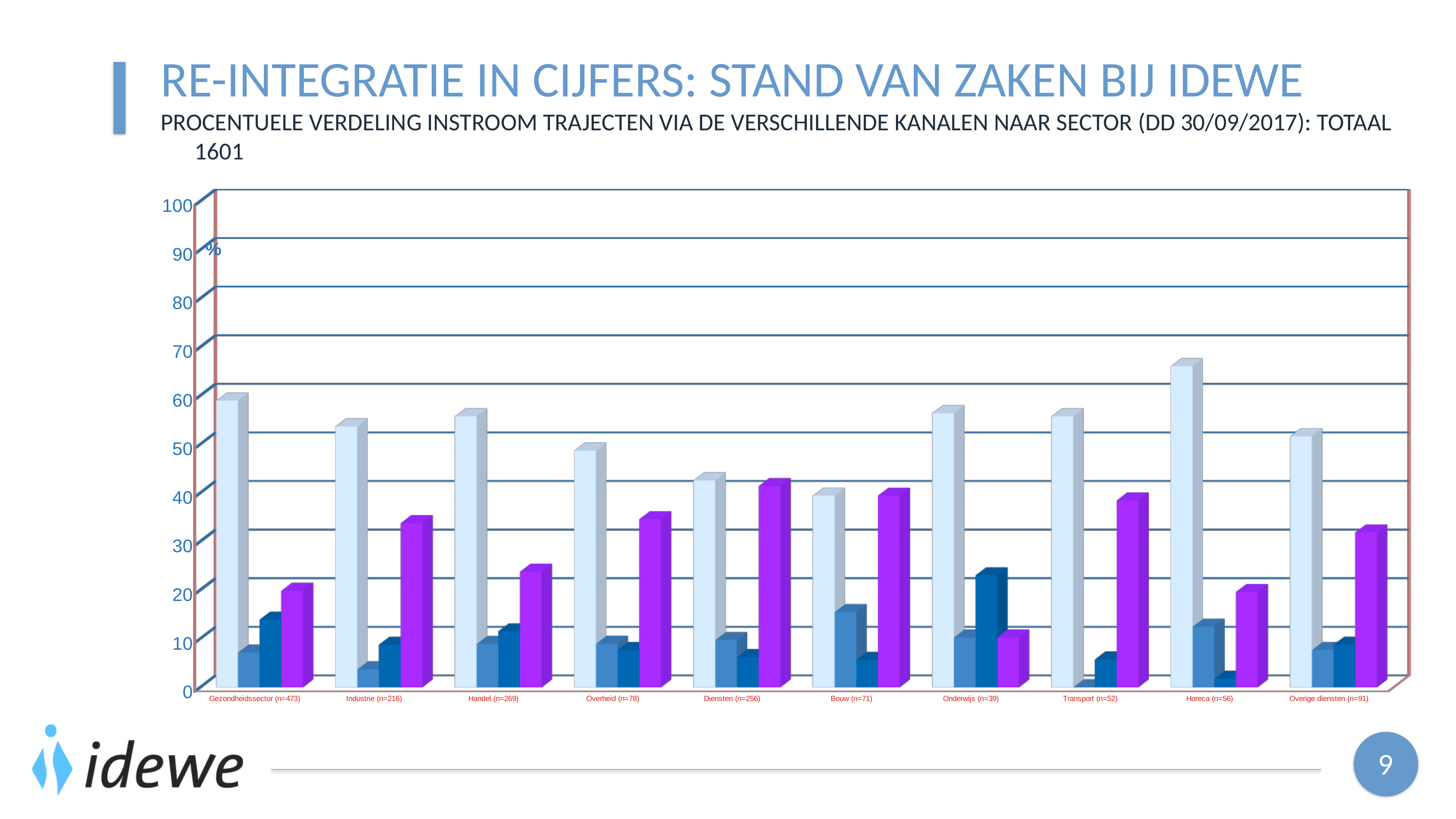
For Gezondheidssector (n=473), which is larger: the light blue (first) bar or the purple (last) bar? the light blue (first) bar What kind of chart is shown on the slide? bar chart Is the purple (last) bar for Industrie (n=216) greater or less than 30? greater Is the light blue (first) bar for Transport (n=52) greater or less than 50? greater What unit is indicated on the vertical axis of the chart? % Which sector has the shortest purple (last) bar? Onderwijs (n=39) Is the dark blue (third) bar for Horeca (n=56) greater or less than 10? less Which is larger: the purple bar for Industrie (n=216) or the purple bar for Handel (n=269)? Industrie (n=216) How many sectors (categories) are shown along the x axis of the chart? 10 Which sector has the tallest light blue (first) bar? Horeca (n=56)